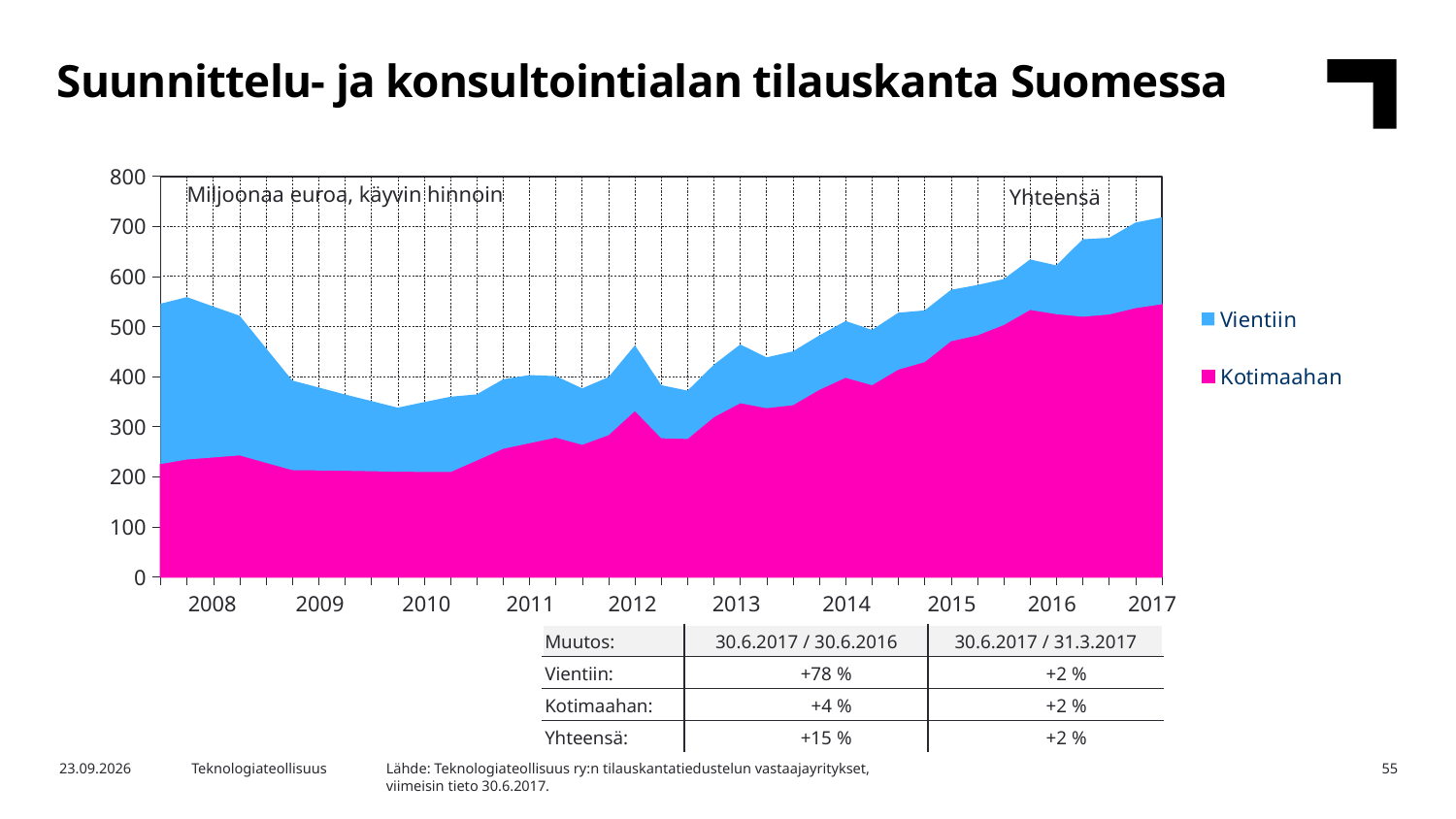
What kind of chart is shown on the slide? Stacked area chart Does the total (Yhteensä) rise or fall from 2008 to 2010? fall Is the value for Kotimaahan at 2017 greater or less than 500? greater At 2017, which series has the larger value, Vientiin or Kotimaahan? Kotimaahan Is the total (Yhteensä) at 2010 greater or less than 400? less What are the two series named in the legend? Vientiin and Kotimaahan Is the total (Yhteensä) at 2017 greater or less than 700? greater Does the Kotimaahan series rise or fall from 2013 to 2017? rise How many series does the legend list? 2 How many years are labelled on the x axis? 10 What is the title of the chart on the slide? Suunnittelu- ja konsultointialan tilauskanta Suomessa